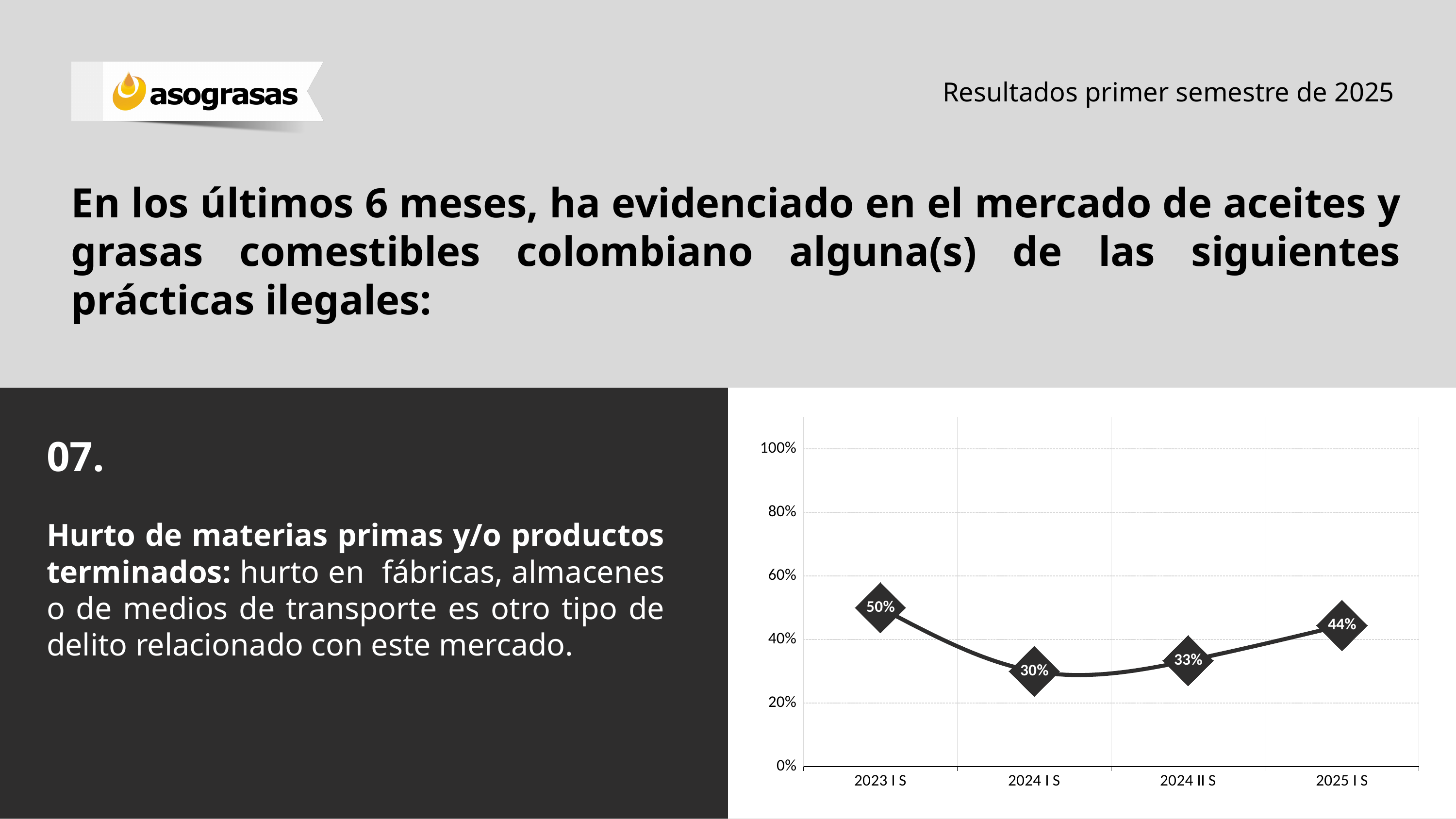
What is the value for 2023 I S? 50% What is the difference between the values for 2025 I S and 2024 II S? 11% Which period has the lowest value? 2024 I S What is the difference between the values for 2023 I S and 2024 I S? 20% Which period has the highest value? 2023 I S What kind of chart is shown on the slide? Line chart What is the value for 2024 I S? 30% How many data points are plotted on the chart? 4 Does the value rise or fall from 2024 I S to 2025 I S? Rise What is the value for 2025 I S? 44% Which is larger, the value for 2025 I S or the value for 2024 II S? 2025 I S What is the value for 2024 II S? 33%